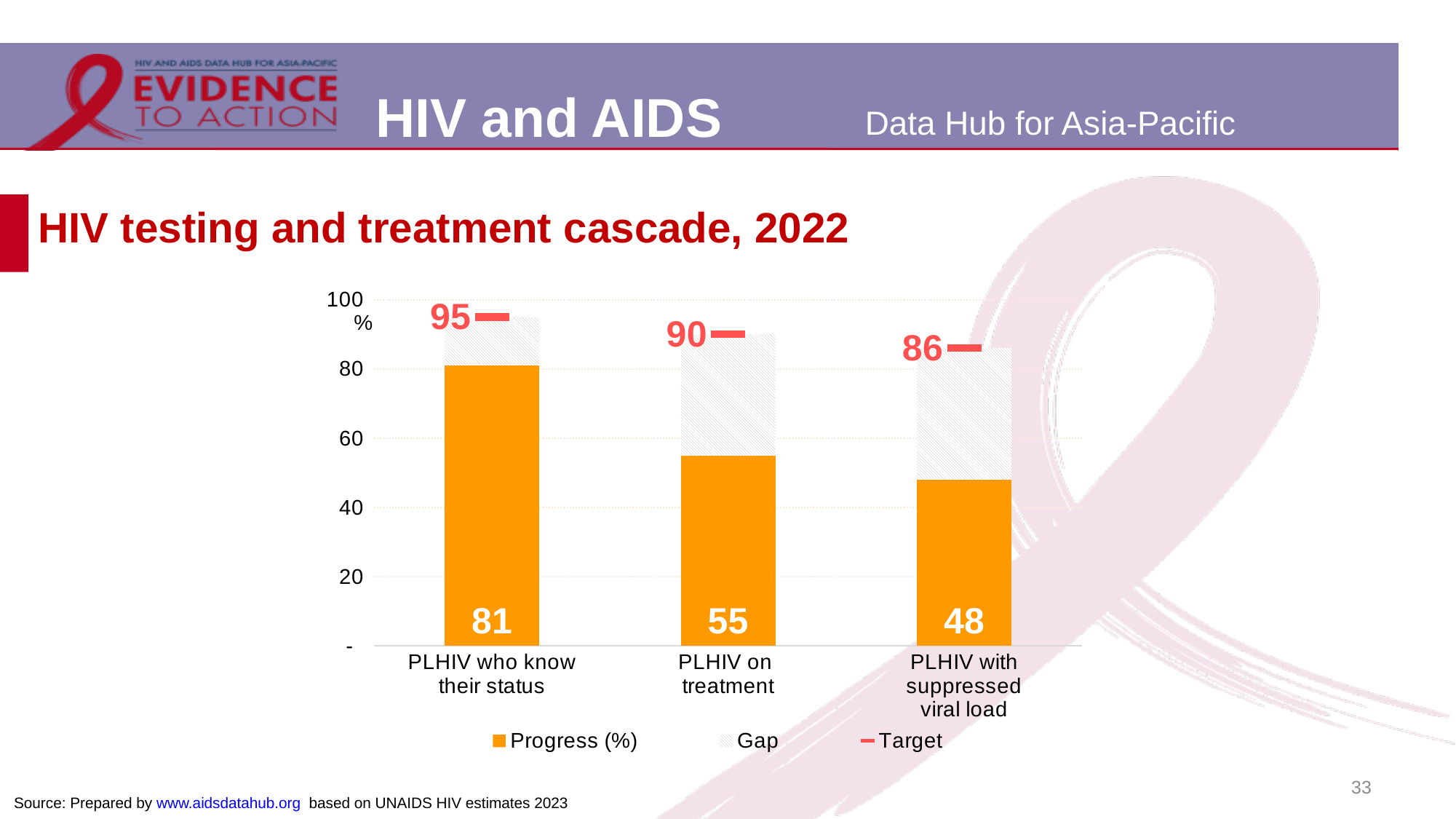
How many categories are shown on the x axis? 3 What is the difference in Progress (%) between PLHIV on treatment and PLHIV with suppressed viral load? 7 What is the difference between the Target and the Progress (%) for PLHIV who know their status? 14 Which category has the highest Progress (%) value? PLHIV who know their status Do the Progress (%) values rise or fall from left to right along the x axis? fall What is the Target value for PLHIV on treatment? 90 How many series does the legend list? 3 What is the Progress (%) value for PLHIV on treatment? 55 Is the Progress (%) for PLHIV on treatment greater or less than 60? less What is the Progress (%) value for PLHIV who know their status? 81 Which category has the lowest Progress (%) value? PLHIV with suppressed viral load What is the Target value for PLHIV with suppressed viral load? 86